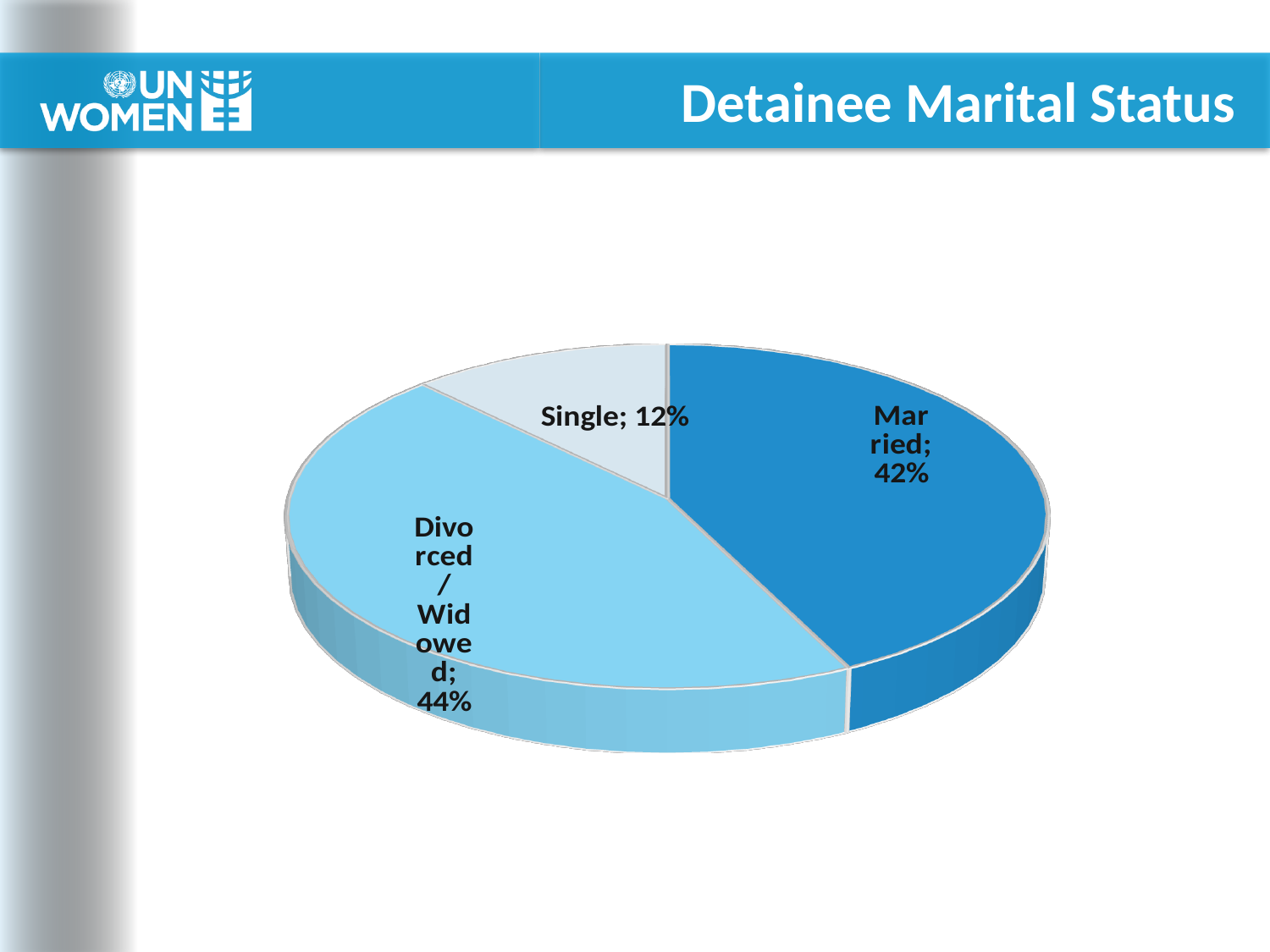
What percentage of detainees are Married? 42% What percentage of detainees are Single? 12% What type of chart is shown on the slide? pie chart Which is larger, the Married slice or the Single slice? Married What is the difference in percentage points between the Divorced/Widowed and Single slices? 32 What is the title of the slide containing the pie chart? Detainee Marital Status Which marital status category has the smallest share? Single How many categories are shown in the pie chart? 3 Which marital status category has the largest share? Divorced/Widowed Which slice of the pie chart is the darkest blue? Married What is the difference in percentage points between the Married and Single slices? 30 What percentage of detainees are Divorced/Widowed? 44%